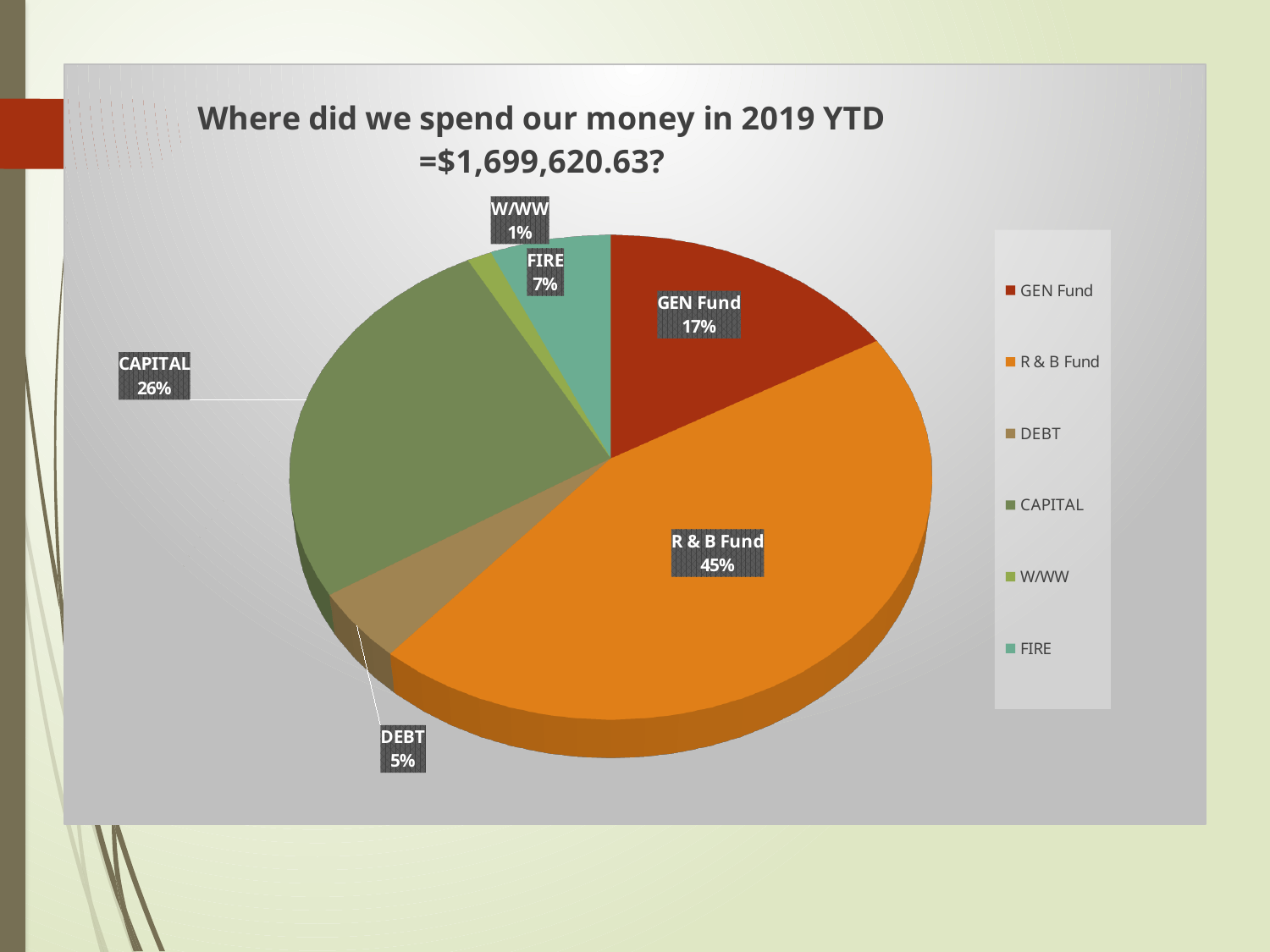
What is the difference in percentage points between the R & B Fund and CAPITAL slices? 19 What percentage is shown for the FIRE slice? 7% What share of spending does the R & B Fund slice represent? 45% What kind of chart is shown on the slide? Pie chart Which category has the smallest share of spending? W/WW Which category has the largest share of spending? R & B Fund What percentage is shown for the W/WW slice? 1% Which is larger, the GEN Fund share or the DEBT share? GEN Fund What percentage is shown for the CAPITAL slice? 26% What total amount is stated in the chart title? $1,699,620.63 How many categories does the pie chart show? 6 What percentage is shown for the GEN Fund slice? 17%